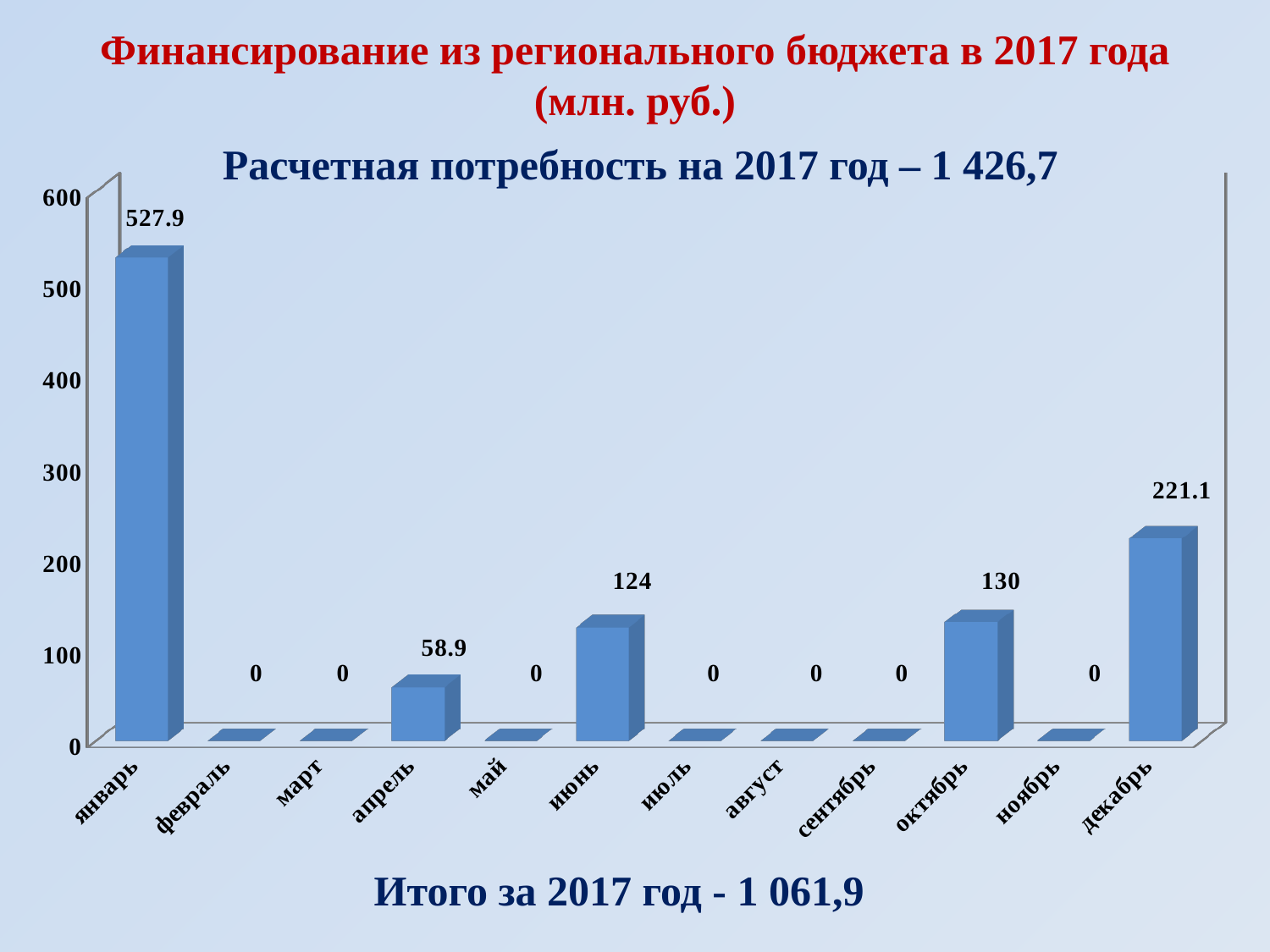
How many months are shown on the x axis? 12 What is the value for апрель? 58.9 What total for 2017 is stated below the chart? 1 061,9 Is the value for январь greater or less than 500? greater What is the difference between the values for декабрь and июнь? 97.1 How many months have a value of 0? 7 Which is larger, the value for октябрь or the value for июнь? октябрь What is the value for октябрь? 130 What is the value for январь? 527.9 Which month has the highest value? январь What kind of chart is shown on the slide? bar chart What is the value for декабрь? 221.1